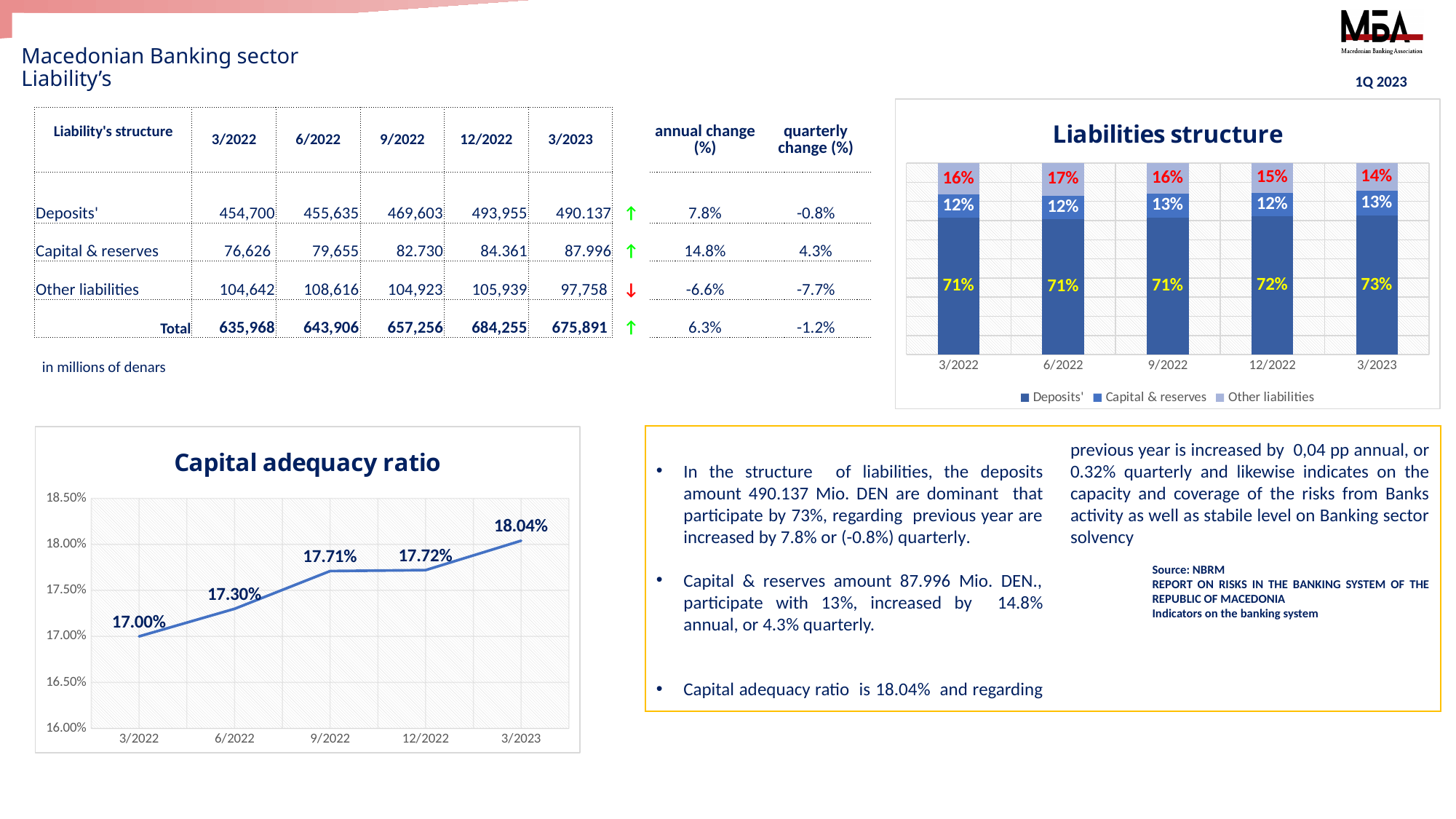
In the Capital adequacy ratio chart, what is the value for 6/2022? 17.30% In the Capital adequacy ratio chart, what is the difference between the 3/2023 and 3/2022 values? 1.04% In the Liabilities structure chart, what share do Capital & reserves have in 9/2022? 13% In the Capital adequacy ratio chart, do the values rise or fall from 3/2022 to 3/2023? Rise In the Capital adequacy ratio chart, what is the value for 3/2023? 18.04% In the Liabilities structure chart, how many periods are shown on the x axis? 5 In the Liabilities structure chart, how many series does the legend list? 3 In the Liabilities structure chart, what share do Deposits' have in 3/2023? 73% In the Capital adequacy ratio chart, which period has the lowest value? 3/2022 What kind of chart is the Liabilities structure chart? Stacked bar chart In the Liabilities structure chart, what share do Other liabilities have in 6/2022? 17% In the Liabilities structure chart, in which period is the Other liabilities share lowest? 3/2023